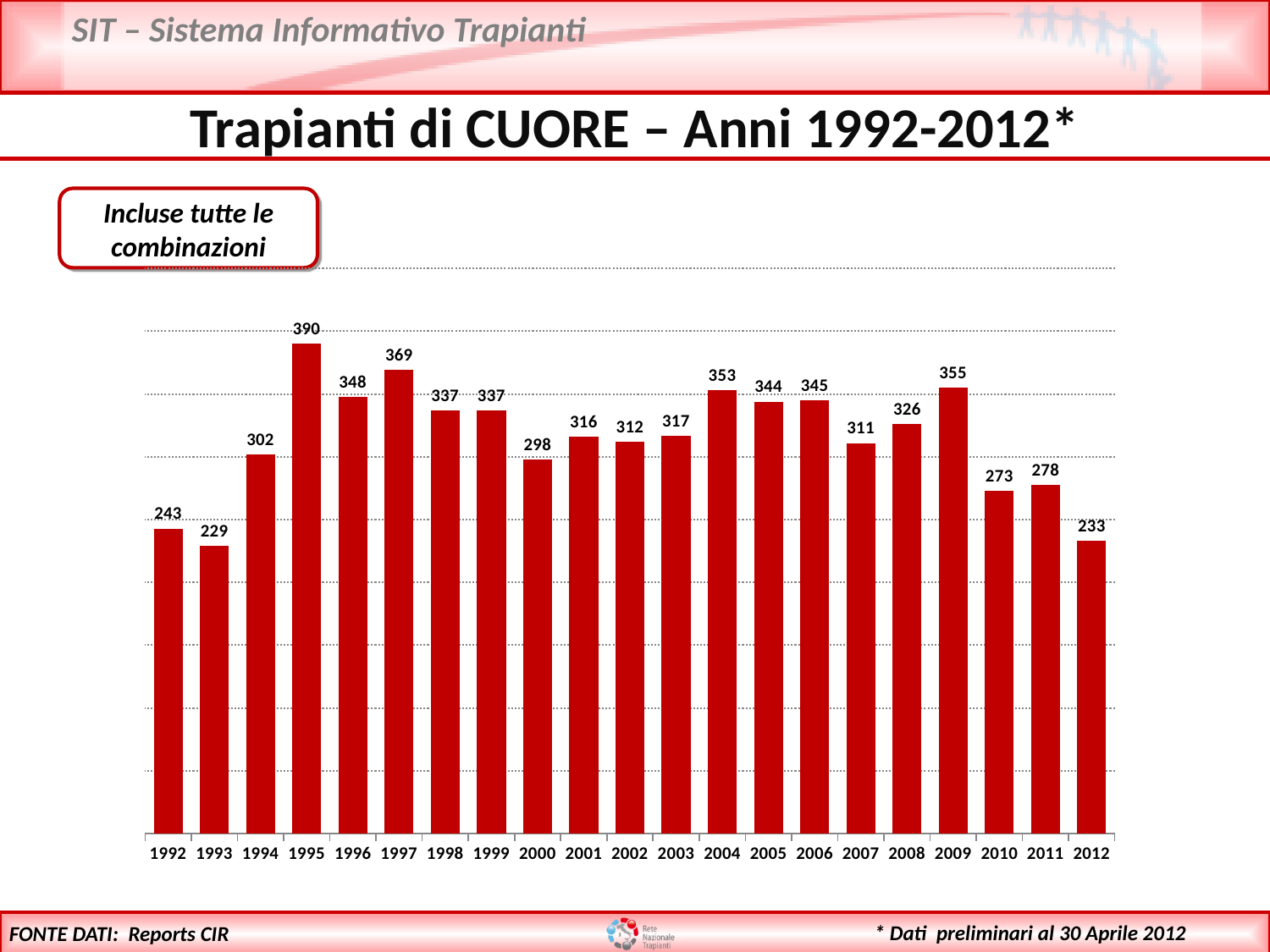
Which is larger, the value for 1997 or the value for 2009? 1997 What is the difference between the values for 2009 and 2010? 82 What is the value for 2012? 233 Which year has the lowest value? 1993 What is the title of the chart? Trapianti di CUORE – Anni 1992-2012* Do the values rise or fall from 2009 to 2012? fall What kind of chart is this? bar chart How many years are shown on the x axis? 21 What is the value for 2004? 353 What is the difference between the values for 1995 and 1993? 161 Which year has the highest value? 1995 What is the value for 1995? 390